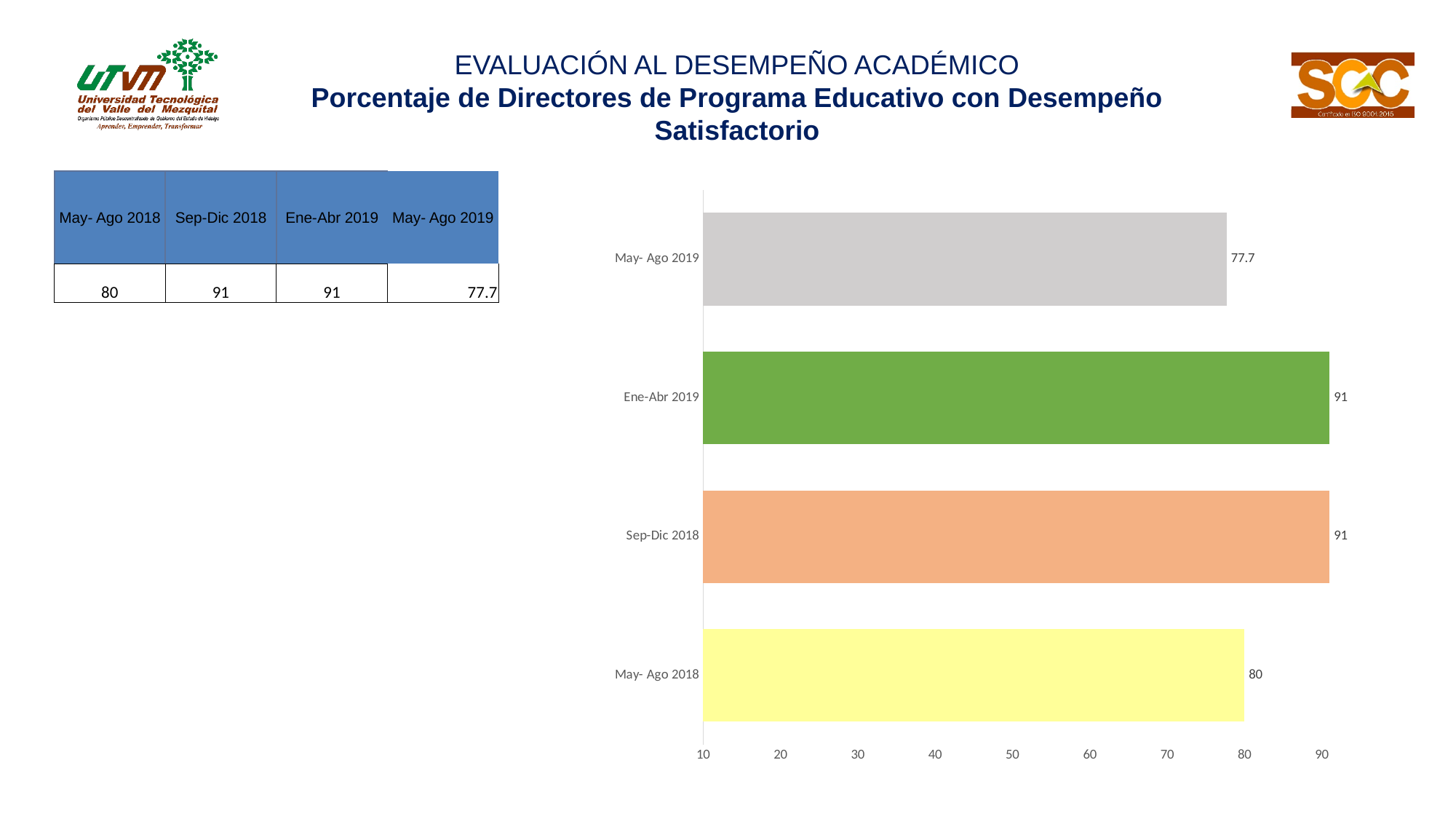
How many periods (bars) are plotted in the chart? 4 What is the value for May- Ago 2019? 77.7 What colour is the bar for Ene-Abr 2019? green Which is larger, the value for Ene-Abr 2019 or the value for May- Ago 2019? Ene-Abr 2019 What is the difference between the values for May- Ago 2018 and May- Ago 2019? 2.3 What is the value for May- Ago 2018? 80 What is the value for Ene-Abr 2019? 91 What type of chart is shown on the slide? bar chart What is the difference between the values for Sep-Dic 2018 and May- Ago 2018? 11 What is the value for Sep-Dic 2018? 91 Is the value for May- Ago 2019 greater or less than 80? less Which period has the lowest value? May- Ago 2019